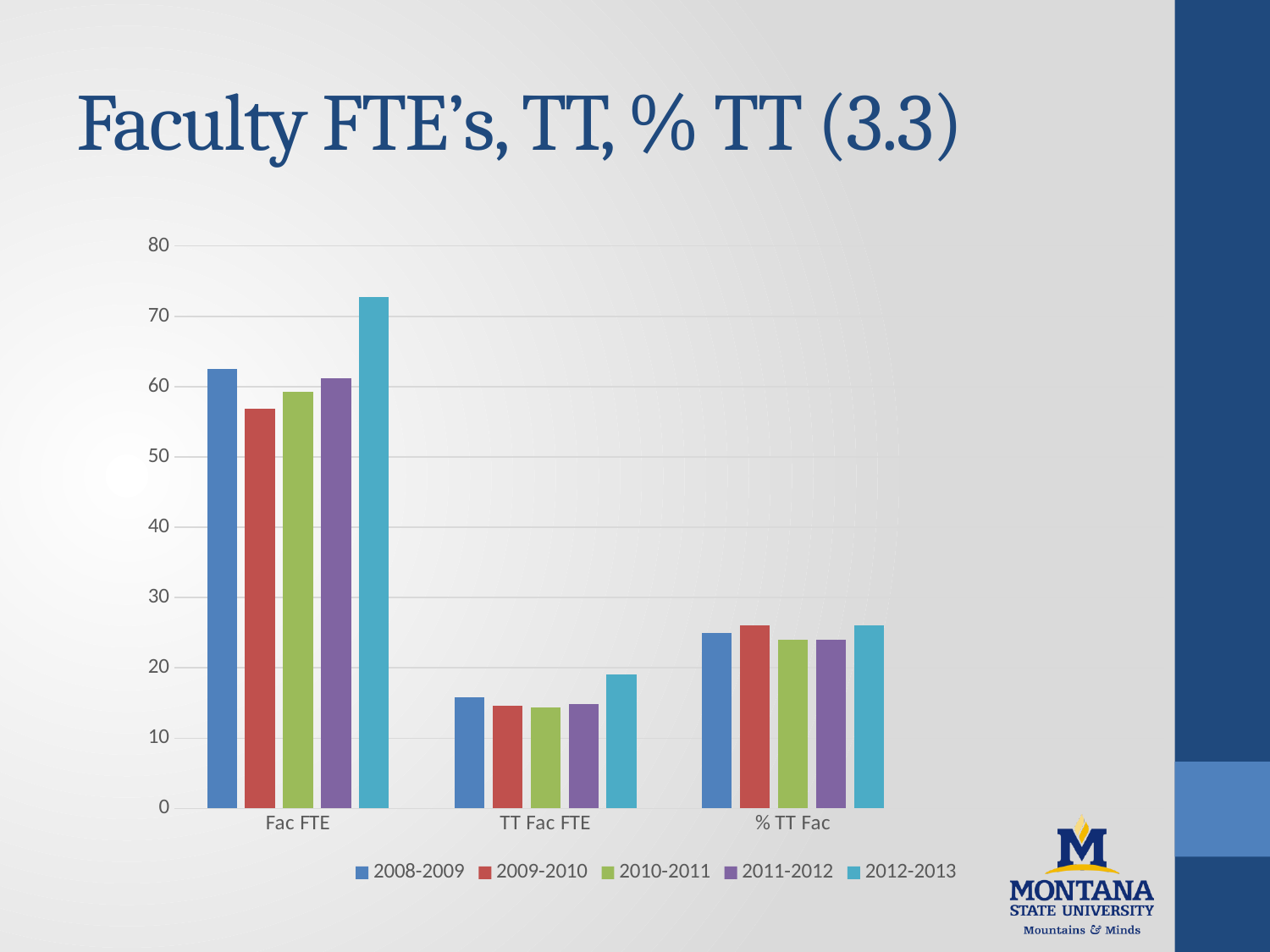
How many categories are shown on the x axis of the chart? 3 Within the Fac FTE category, which year has the lowest bar? 2009-2010 What is the title of the slide containing the chart? Faculty FTE's, TT, % TT (3.3) How many series does the legend list? 5 Is the Fac FTE value for 2012-2013 greater or less than 70? greater Within the Fac FTE category, which year has the highest bar? 2012-2013 In the Fac FTE category, which is larger: the 2008-2009 bar or the 2009-2010 bar? 2008-2009 Is the % TT Fac value for 2008-2009 greater or less than 20? greater What kind of chart is shown on the slide? Bar chart Is the Fac FTE value for 2009-2010 greater or less than 60? less Within the TT Fac FTE category, which year has the highest bar? 2012-2013